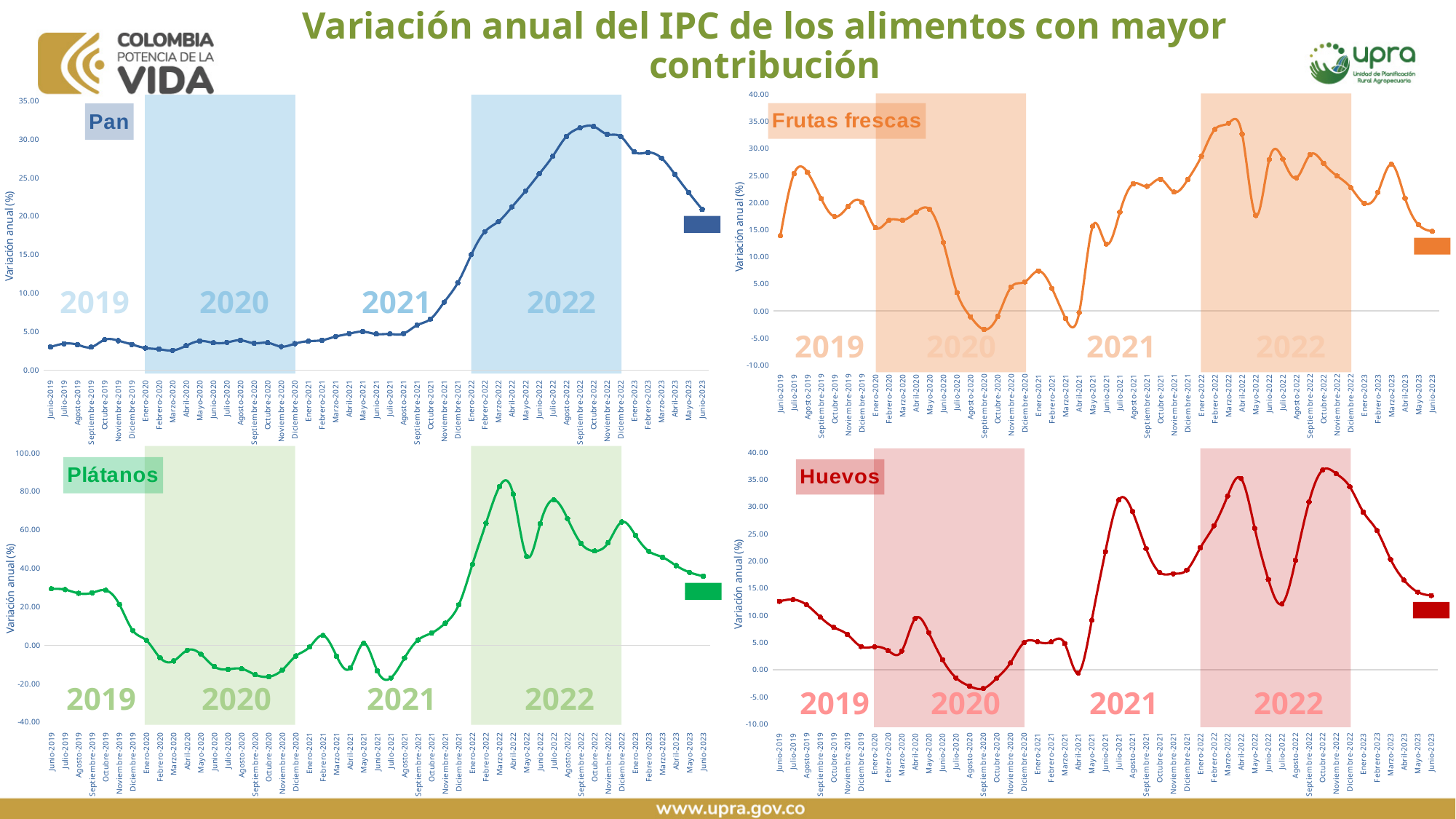
What is the title of the slide? Variación anual del IPC de los alimentos con mayor contribución In the 'Huevos' chart, is the value for Septiembre-2020 greater or less than 0.00? less In the 'Plátanos' chart, is the value for Marzo-2022 greater or less than 60.00? greater In the 'Pan' chart, do the values rise or fall from Enero-2023 to Junio-2023? fall In the 'Frutas frescas' chart, is the value for Marzo-2022 greater or less than 30.00? greater In the 'Pan' chart, do the values rise or fall from Enero-2022 to Octubre-2022? rise What kind of chart is the 'Pan' chart? line chart